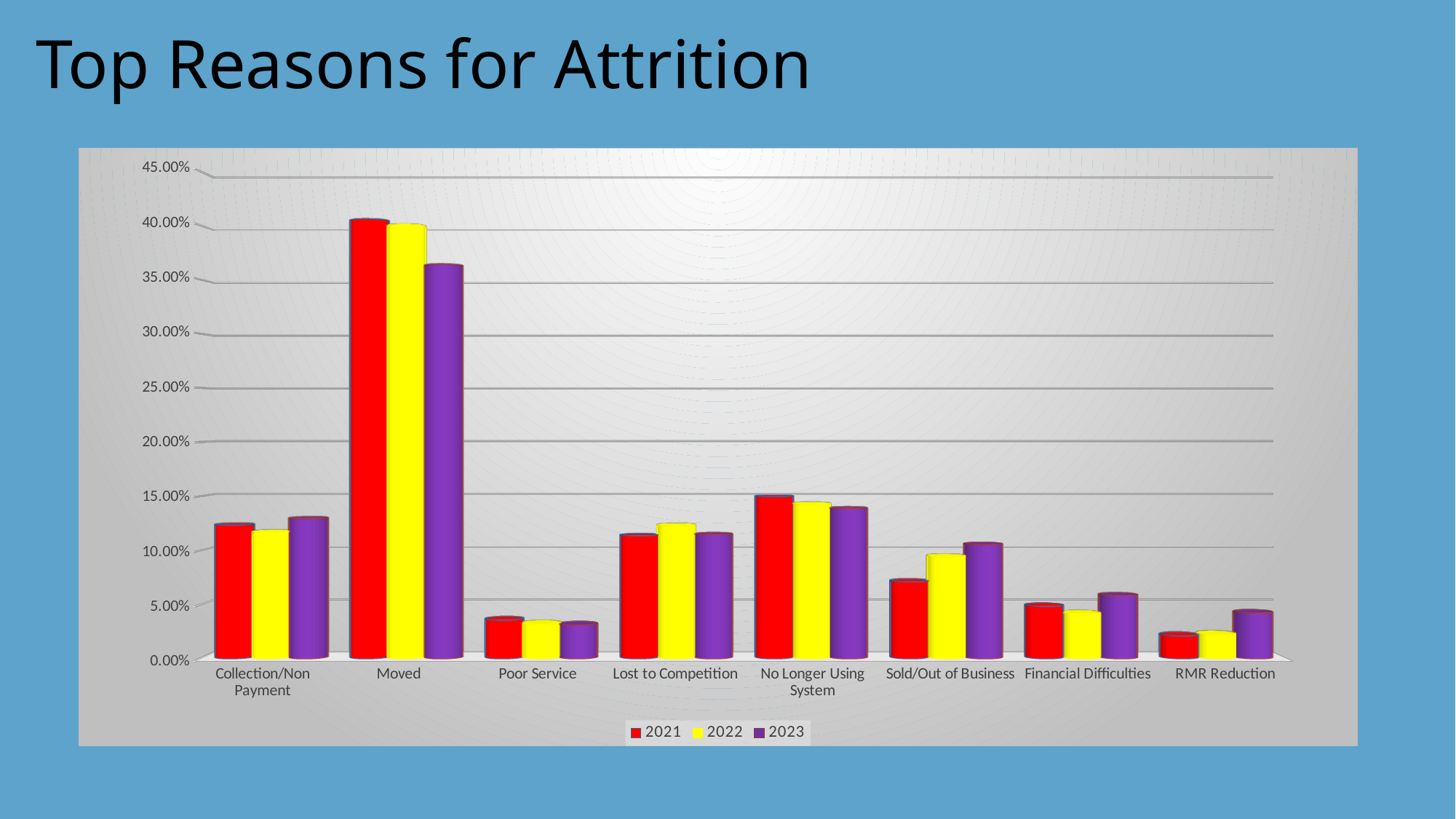
Which category has the lowest value for 2021? RMR Reduction Which colour represents the 2022 series in the legend? yellow Is the value for Collection/Non Payment in 2021 greater or less than 10.00%? greater What kind of chart is shown on the slide? bar chart Is the value for Sold/Out of Business in 2021 greater or less than 5.00%? greater Is the value for Poor Service in 2021 greater or less than 5.00%? less How many series does the legend list? 3 Which category has the highest value for 2021? Moved How many attrition reason categories are shown on the x axis? 8 Which is larger for Moved: the 2021 value or the 2023 value? 2021 Do the values for Sold/Out of Business rise or fall from 2021 to 2023? rise